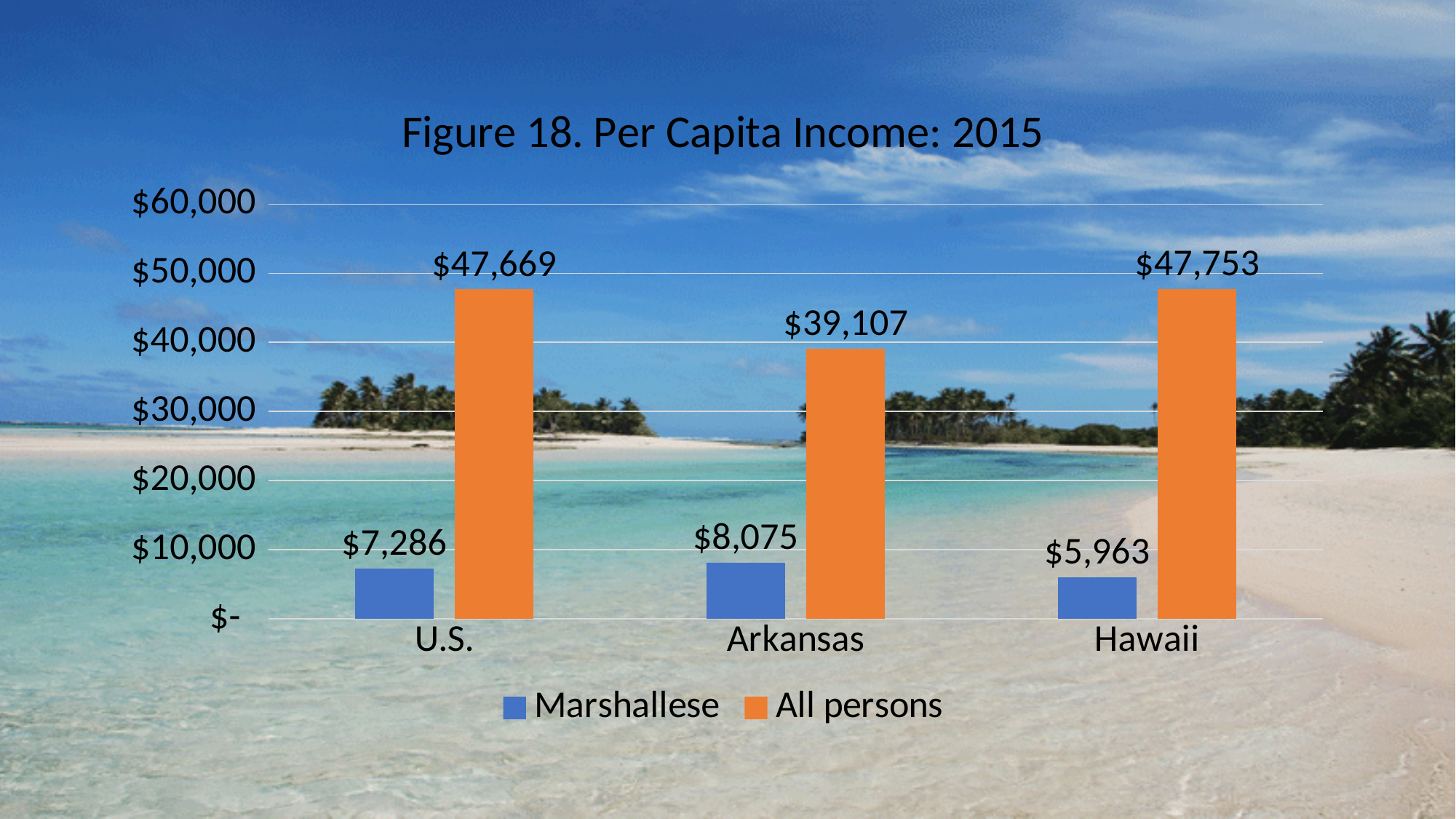
What is the difference between the All persons and Marshallese per capita income in Arkansas? $31,032 How many locations are shown on the x axis? 3 What type of chart is shown on the slide? bar chart Which location has the highest Marshallese per capita income? Arkansas Which location has the lowest Marshallese per capita income? Hawaii How many series does the legend list? 2 What is the difference between the Marshallese per capita income in Arkansas and in Hawaii? $2,112 Which location has the lowest per capita income for All persons? Arkansas Is the Marshallese per capita income in the U.S. larger or smaller than the Marshallese per capita income in Hawaii? larger What is the per capita income for Marshallese in Arkansas? $8,075 What is the per capita income for All persons in Hawaii? $47,753 What is the per capita income for Marshallese in the U.S.? $7,286